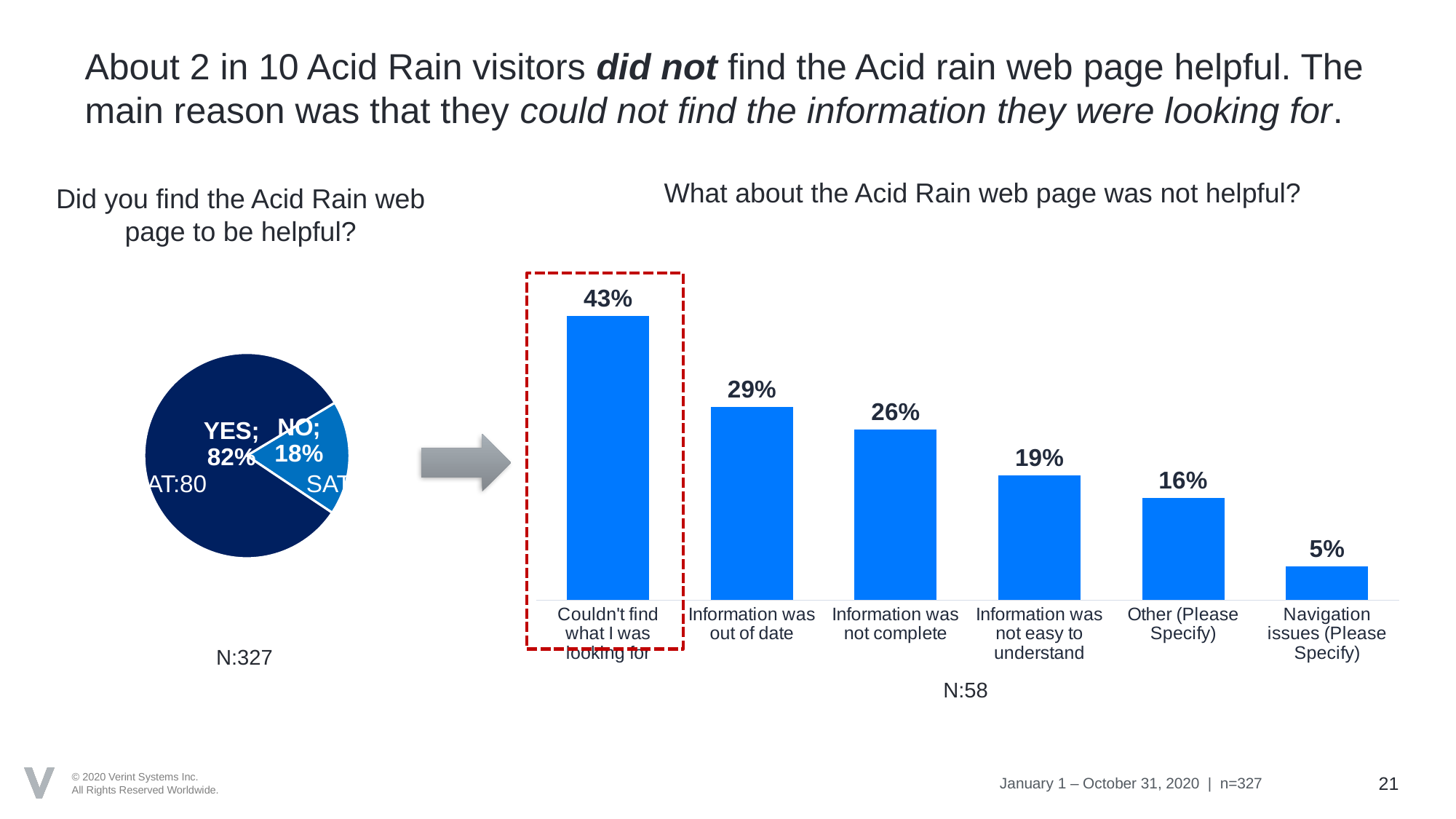
In the pie chart 'Did you find the Acid Rain web page to be helpful?', what percentage answered YES? 82% What type of chart is 'What about the Acid Rain web page was not helpful?' bar chart In the pie chart 'Did you find the Acid Rain web page to be helpful?', which slice is larger, YES or NO? YES In the chart 'What about the Acid Rain web page was not helpful?', what is the value for 'Information was not easy to understand'? 19% In the chart 'What about the Acid Rain web page was not helpful?', which category has the highest value? Couldn't find what I was looking for What type of chart is used for 'Did you find the Acid Rain web page to be helpful?' pie chart In the chart 'What about the Acid Rain web page was not helpful?', do the values rise or fall from left to right? fall In the chart 'What about the Acid Rain web page was not helpful?', what is the value for 'Information was out of date'? 29% In the chart 'What about the Acid Rain web page was not helpful?', what is the difference between 'Couldn't find what I was looking for' and 'Information was not complete'? 17% In the chart 'What about the Acid Rain web page was not helpful?', which category has the lowest value? Navigation issues (Please Specify) In the pie chart 'Did you find the Acid Rain web page to be helpful?', what percentage answered NO? 18% In the chart 'What about the Acid Rain web page was not helpful?', how many categories are shown? 6